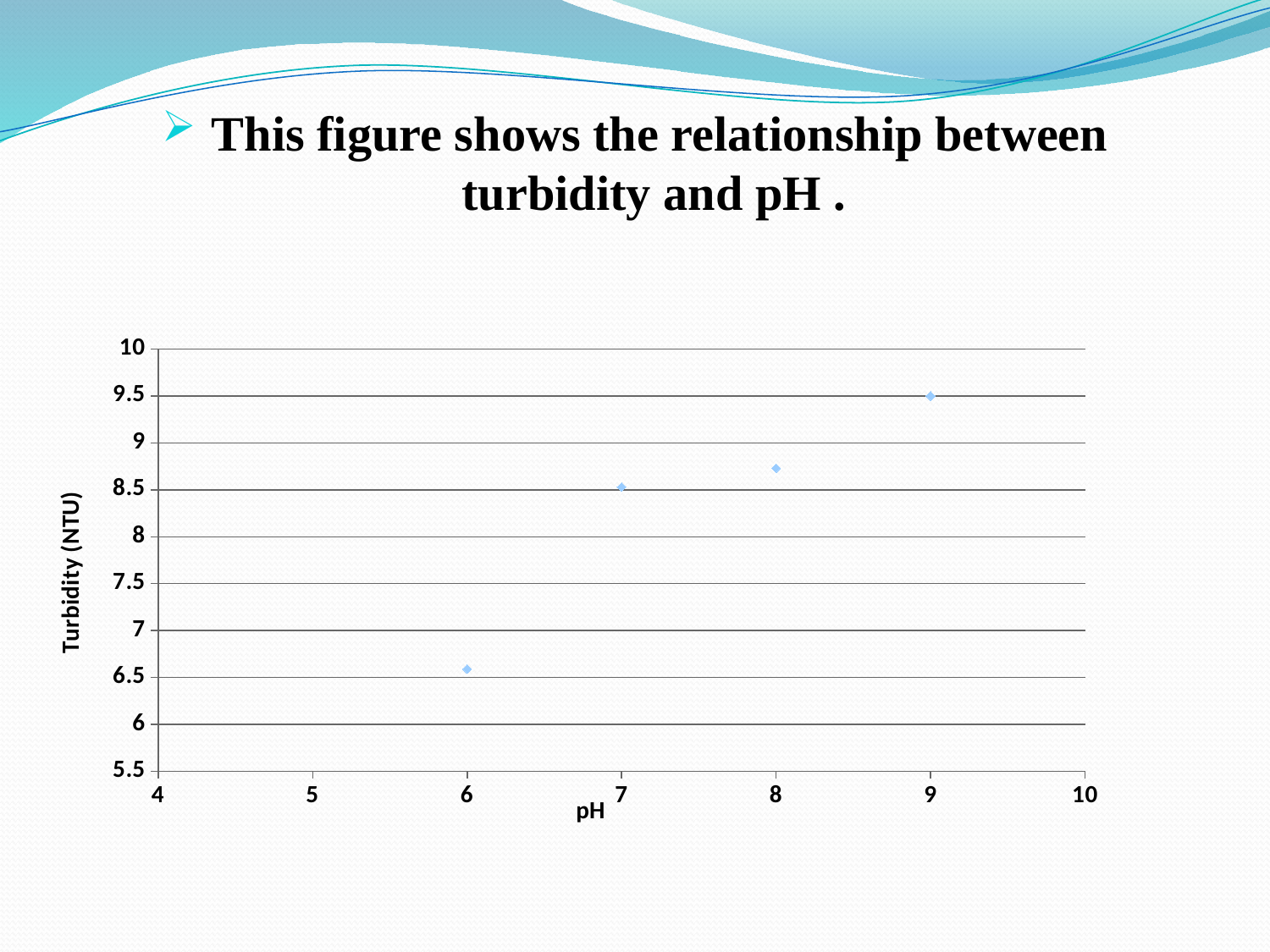
Is the turbidity value at pH 7 greater or less than 8? greater At which pH value is turbidity highest? 9 Does turbidity rise or fall as pH increases along the x axis? rise What kind of chart is shown on the slide? scatter chart How many data points are plotted on the chart? 4 Is the turbidity value at pH 9 greater or less than 9? greater Which has the higher turbidity, pH 6 or pH 7? pH 7 What is the label of the horizontal axis? pH What is the label of the vertical axis? Turbidity (NTU) Is the turbidity value at pH 6 greater or less than 7? less At which pH value is turbidity lowest? 6